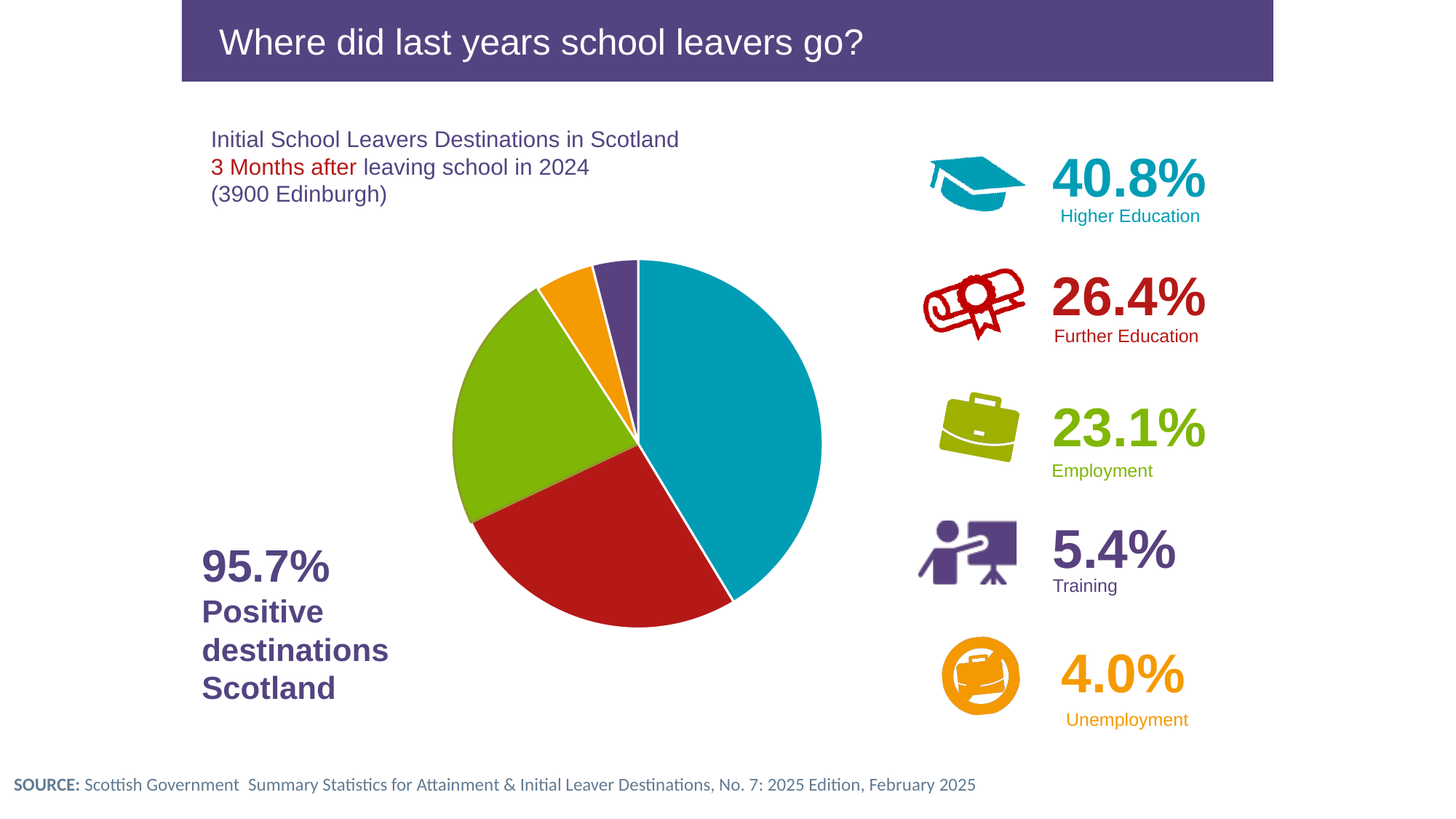
What percentage of school leavers went into Employment? 23.1% What colour is the slice representing Employment? green What is the difference in percentage points between Higher Education and Further Education? 14.4 Which destination has the largest share of the pie? Higher Education What percentage of school leavers went into Unemployment? 4.0% Which is larger, the share for Further Education or the share for Employment? Further Education What percentage of school leavers went into Further Education? 26.4% What percentage of school leavers went into Training? 5.4% How many slices does the pie chart have? 5 What percentage of school leavers went into Higher Education? 40.8% What kind of chart is shown on the slide? pie chart